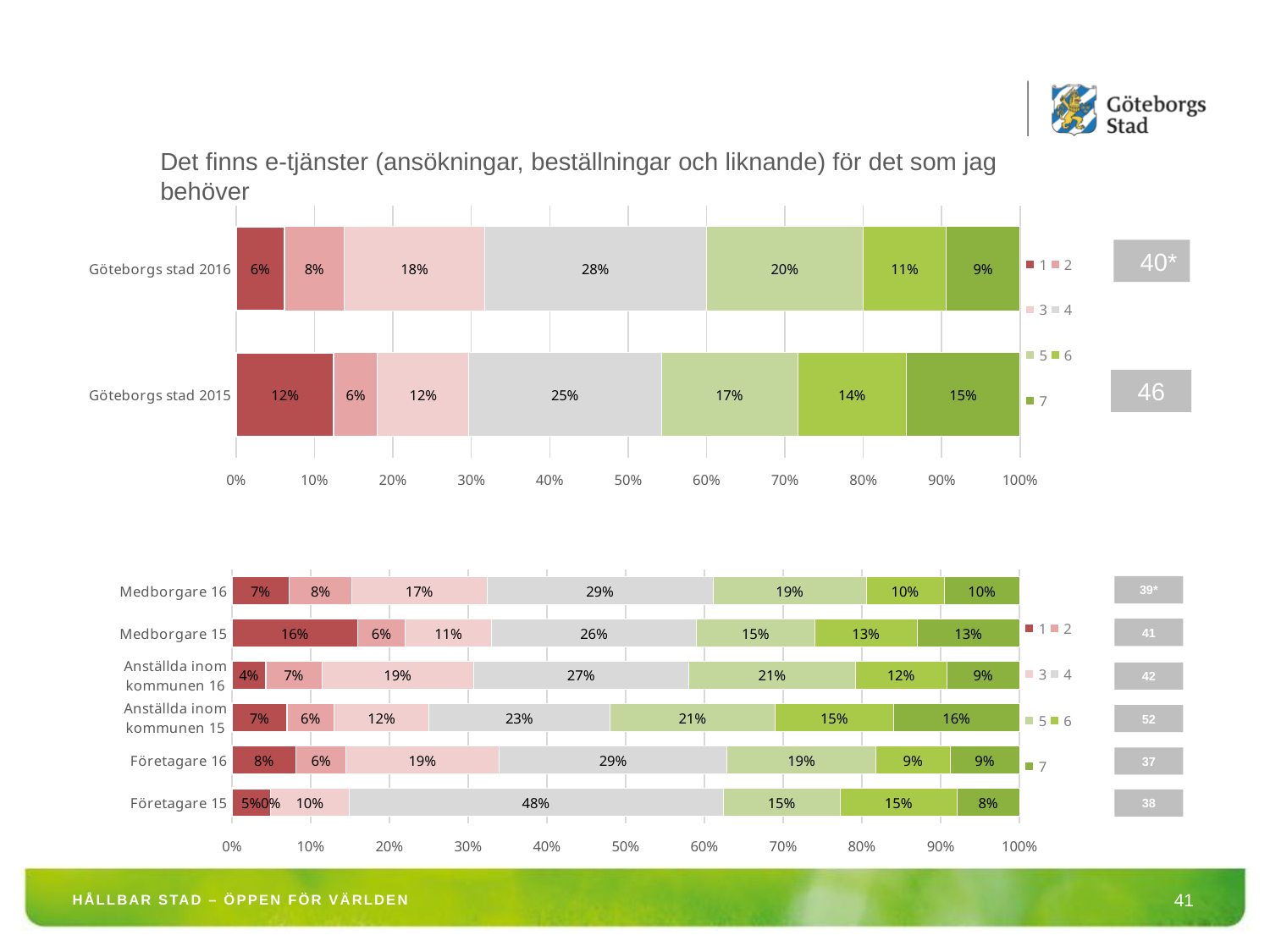
In the top chart, how many series does the legend list? 7 In the bottom chart, what is the value of series 1 for Medborgare 15? 16% In the top chart, how many categories are plotted? 2 In the bottom chart, which category has the highest value for series 4? Företagare 15 In the top chart, what is the value of series 4 for Göteborgs stad 2016? 28% In the bottom chart, what is the value of series 4 for Företagare 15? 48% What kind of chart is the top chart? Stacked bar chart In the bottom chart, what is the value of series 2 for Företagare 15? 0% In the bottom chart, how many categories are plotted? 6 In the bottom chart, which has the larger series 5 value: Anställda inom kommunen 16 or Medborgare 16? Anställda inom kommunen 16 In the top chart, what is the value of series 7 for Göteborgs stad 2015? 15% In the top chart, what is the difference between the series 1 values for Göteborgs stad 2015 and Göteborgs stad 2016? 6 percentage points